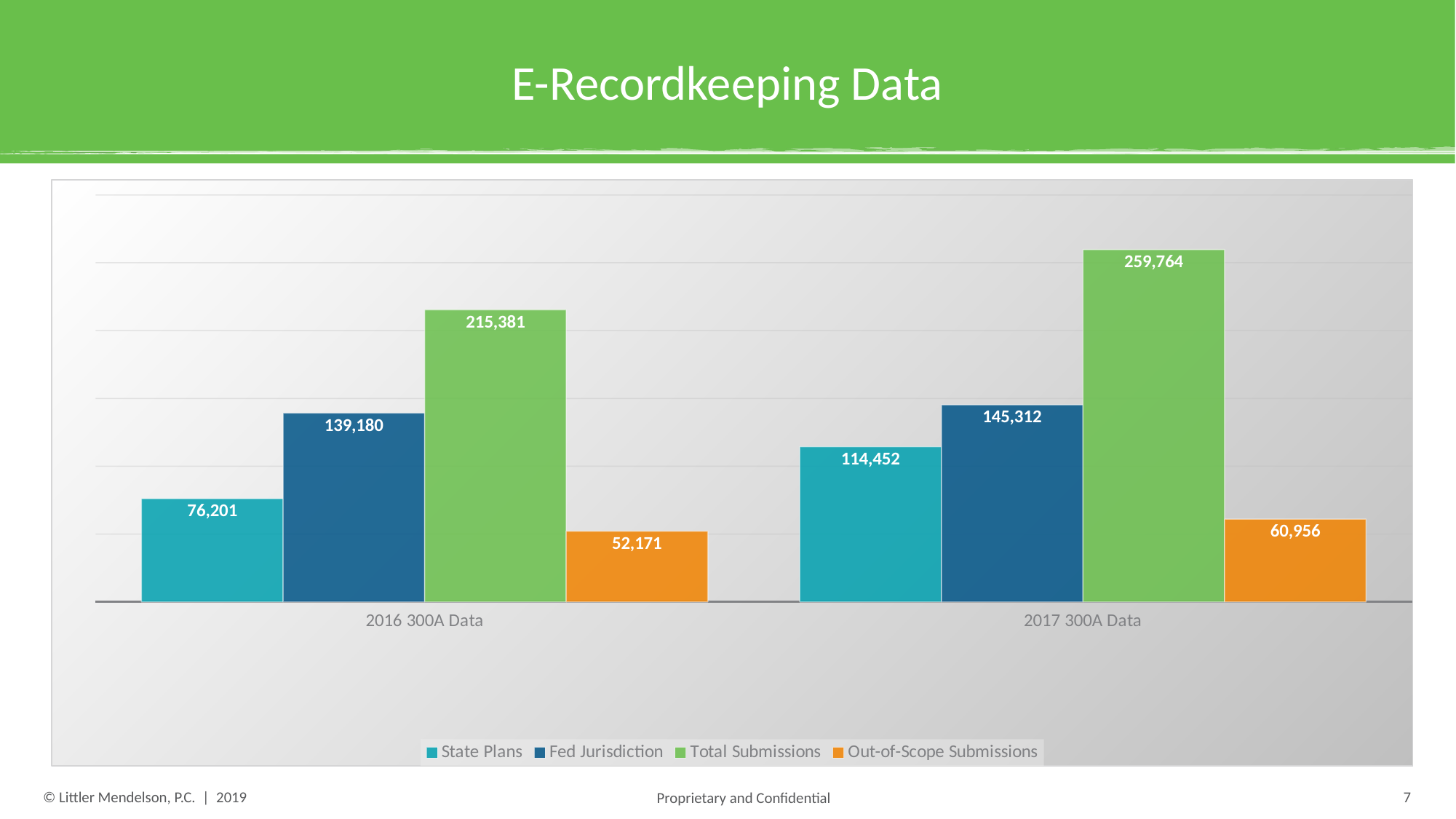
Does the value for Out-of-Scope Submissions rise or fall from 2016 300A Data to 2017 300A Data? Rise Which series has the highest value in 2017 300A Data? Total Submissions Which is larger: State Plans in 2017 300A Data or Fed Jurisdiction in 2016 300A Data? Fed Jurisdiction in 2016 300A Data What kind of chart is shown on the slide? Bar chart What is the value for Out-of-Scope Submissions in 2016 300A Data? 52,171 What is the difference between Total Submissions in 2017 300A Data and 2016 300A Data? 44,383 What is the value for Total Submissions in 2017 300A Data? 259,764 What is the value for State Plans in 2016 300A Data? 76,201 What is the value for Fed Jurisdiction in 2017 300A Data? 145,312 What is the difference between Fed Jurisdiction and State Plans in 2016 300A Data? 62,979 Which series has the lowest value in 2016 300A Data? Out-of-Scope Submissions How many series does the legend list? 4